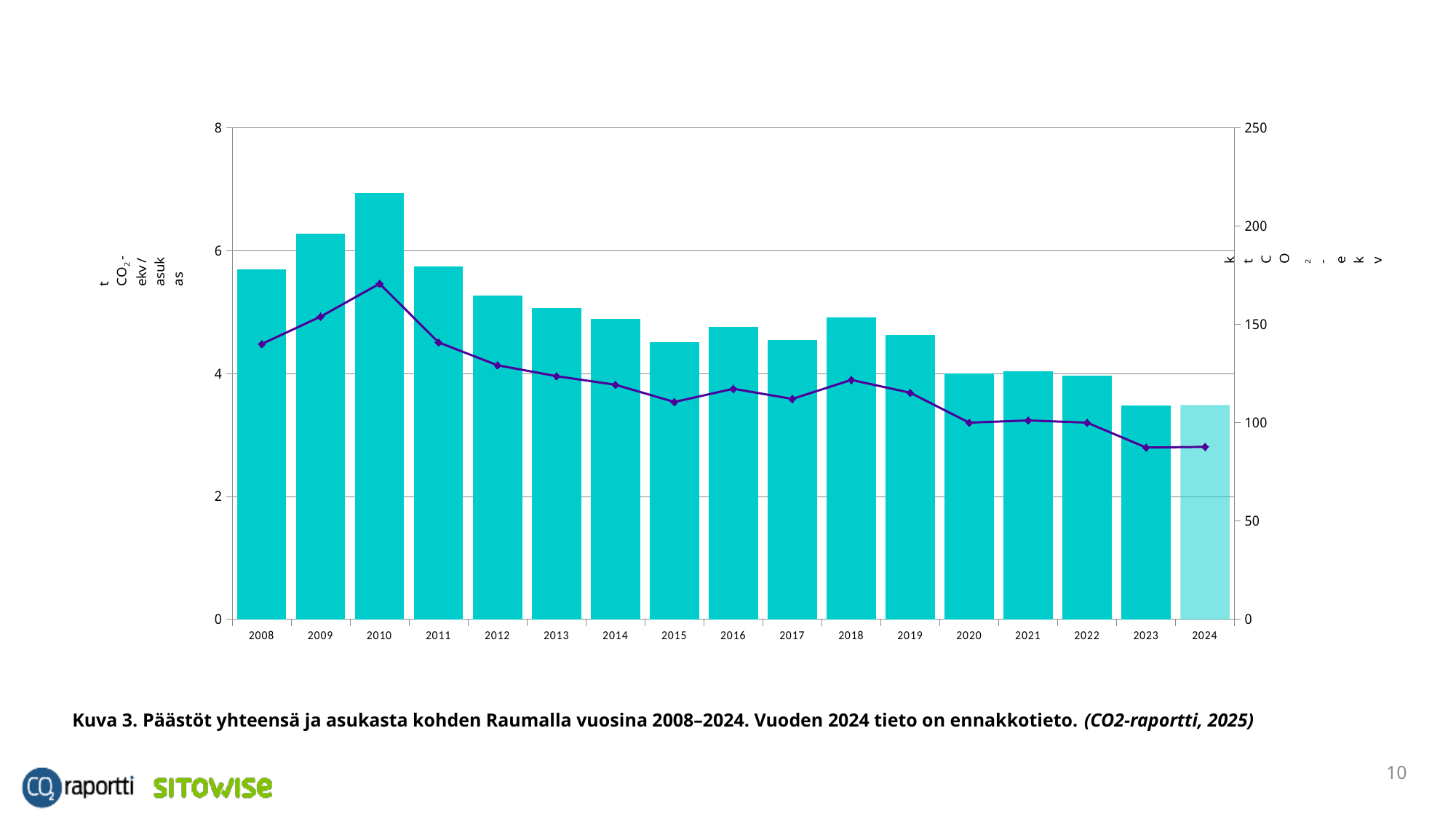
What is the upper limit of the right-hand axis of the chart? 250 Do the bar values generally rise or fall from 2010 to 2024? Fall Is the bar value for 2023 greater or less than 4 on the left axis? less In which year does the line series reach its highest point? 2010 Which year has the tallest bar in the chart? 2010 Is the bar value for 2008 greater or less than 6 on the left axis? less Is the line value for 2010 greater or less than 150 on the right axis? greater How many years are shown on the x axis of the chart? 17 What kind of chart is shown on the slide? A bar chart with a line series Which bar is taller, 2009 or 2011? 2009